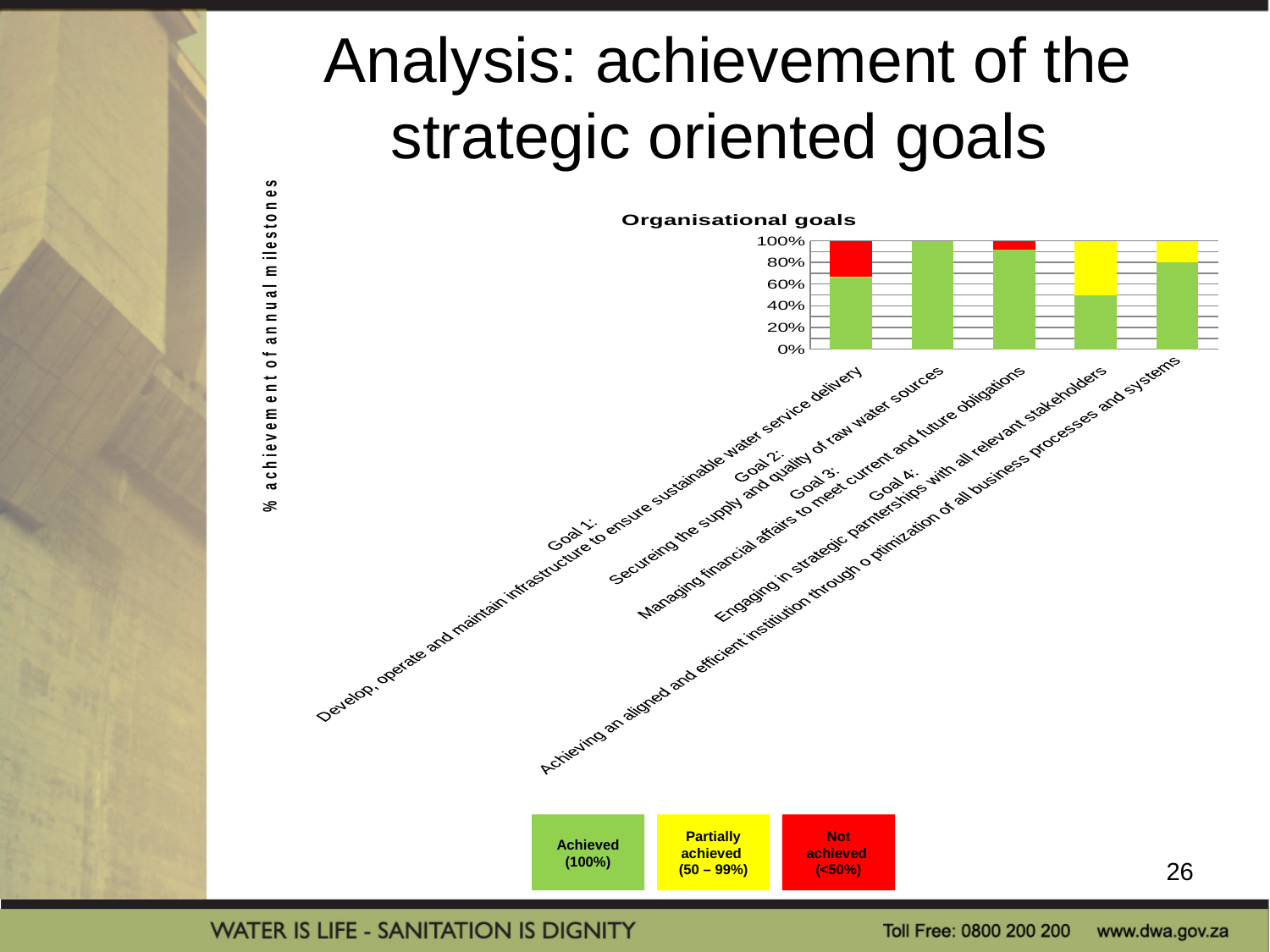
Is the green (Achieved) segment for Goal 1 greater or less than 60%? greater What kind of chart is shown on the slide? Stacked bar chart What is the title of the chart? Organisational goals Which goal has the smallest green (Achieved) segment? Goal 4 Which colour represents 'Not achieved (<50%)' in the chart? Red How many goals (categories) are plotted in the Organisational goals chart? 5 Is the green (Achieved) segment for Goal 4 greater or less than 60%? less How many categories does the legend at the bottom of the slide list? 3 Which goal has the largest green (Achieved) segment? Goal 2 Which has the larger green (Achieved) segment, Goal 1 or Goal 4? Goal 1 Is the green (Achieved) segment for Goal 3 greater or less than 80%? greater